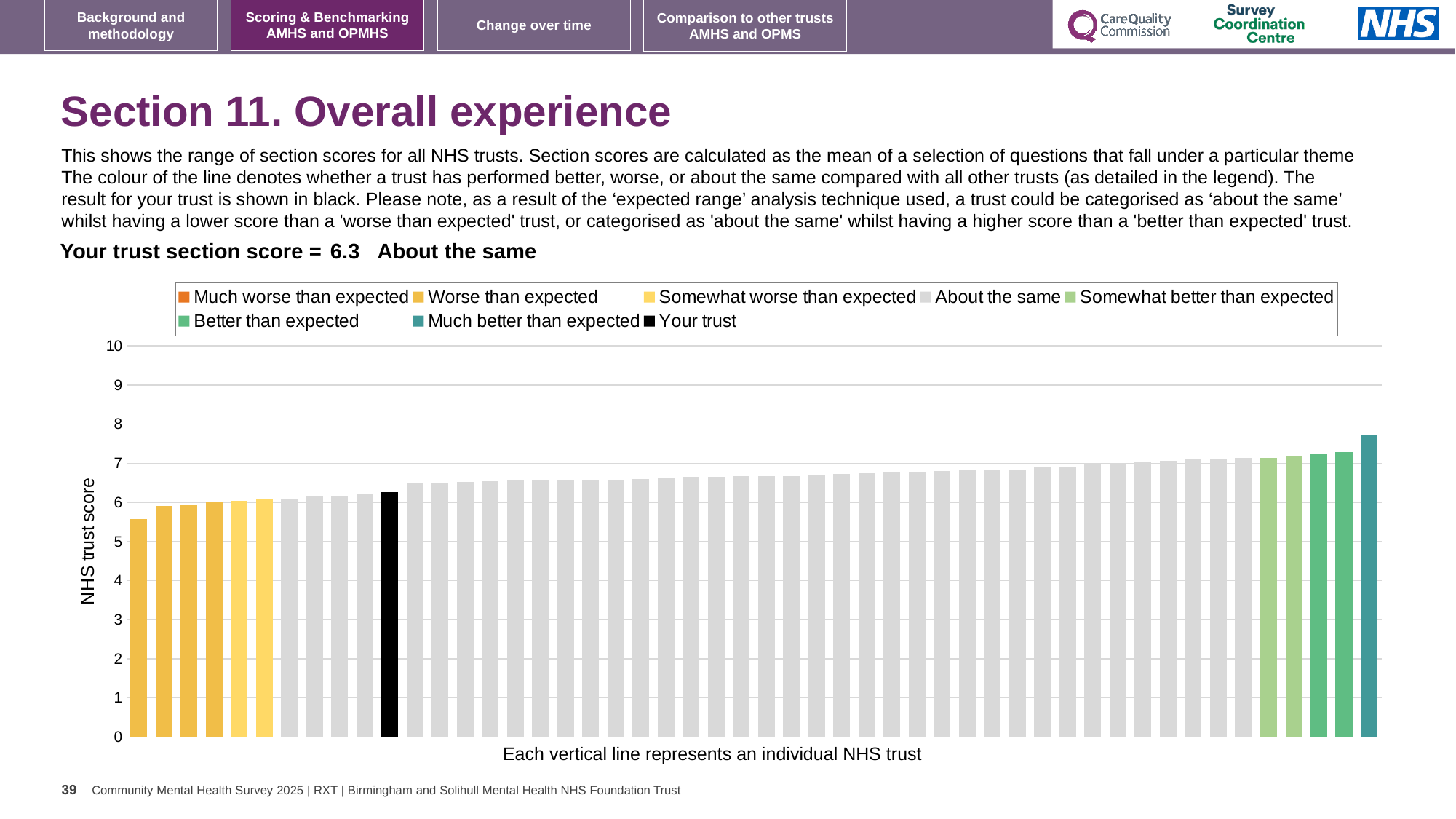
Which legend category does the tallest bar belong to? Much better than expected What is the section score for your trust shown on the slide? 6.3 Is the value for your trust (the black bar) greater or less than 6? greater How many entries does the chart legend list? 8 Which performance category is your trust placed in for this section? About the same Is the value of the tallest bar greater or less than 7? greater Do the bar values rise or fall from left to right along the x axis? rise Is the value of the shortest bar greater or less than 6? less How many bars are coloured as 'Much better than expected'? 1 What kind of chart is shown on the slide? bar chart What is the label on the vertical axis of the chart? NHS trust score